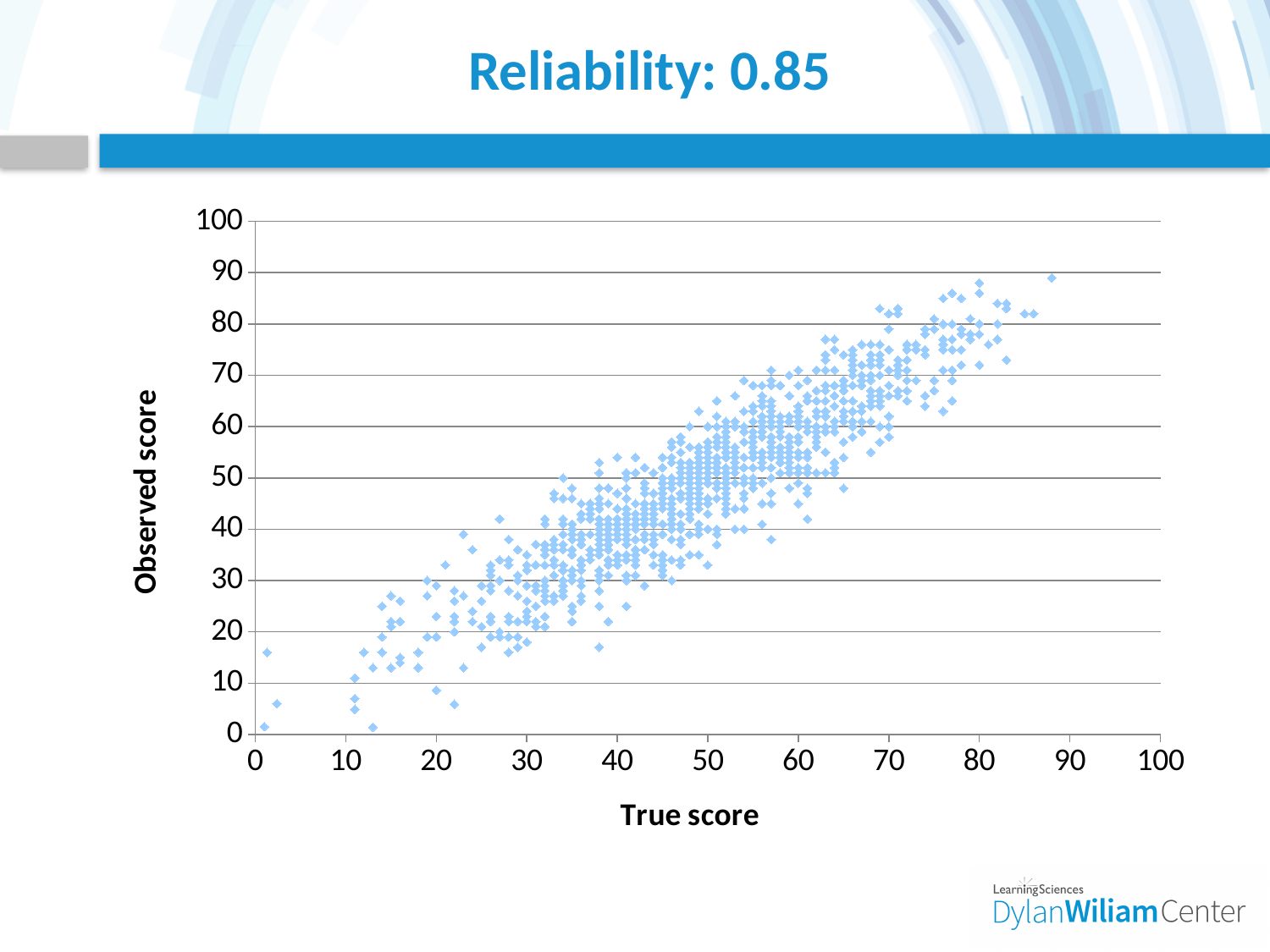
Is the smallest true score plotted greater or less than 10? less What is the maximum value shown on the x axis? 100 What is the maximum value shown on the y axis? 100 What kind of chart is shown on the slide? scatter plot Is the largest true score plotted greater or less than 80? greater Is the highest observed score plotted greater or less than 80? greater As the true score increases along the x axis, do the observed scores generally rise or fall? rise What is the title of the chart? Reliability: 0.85 What is the label of the x axis? True score